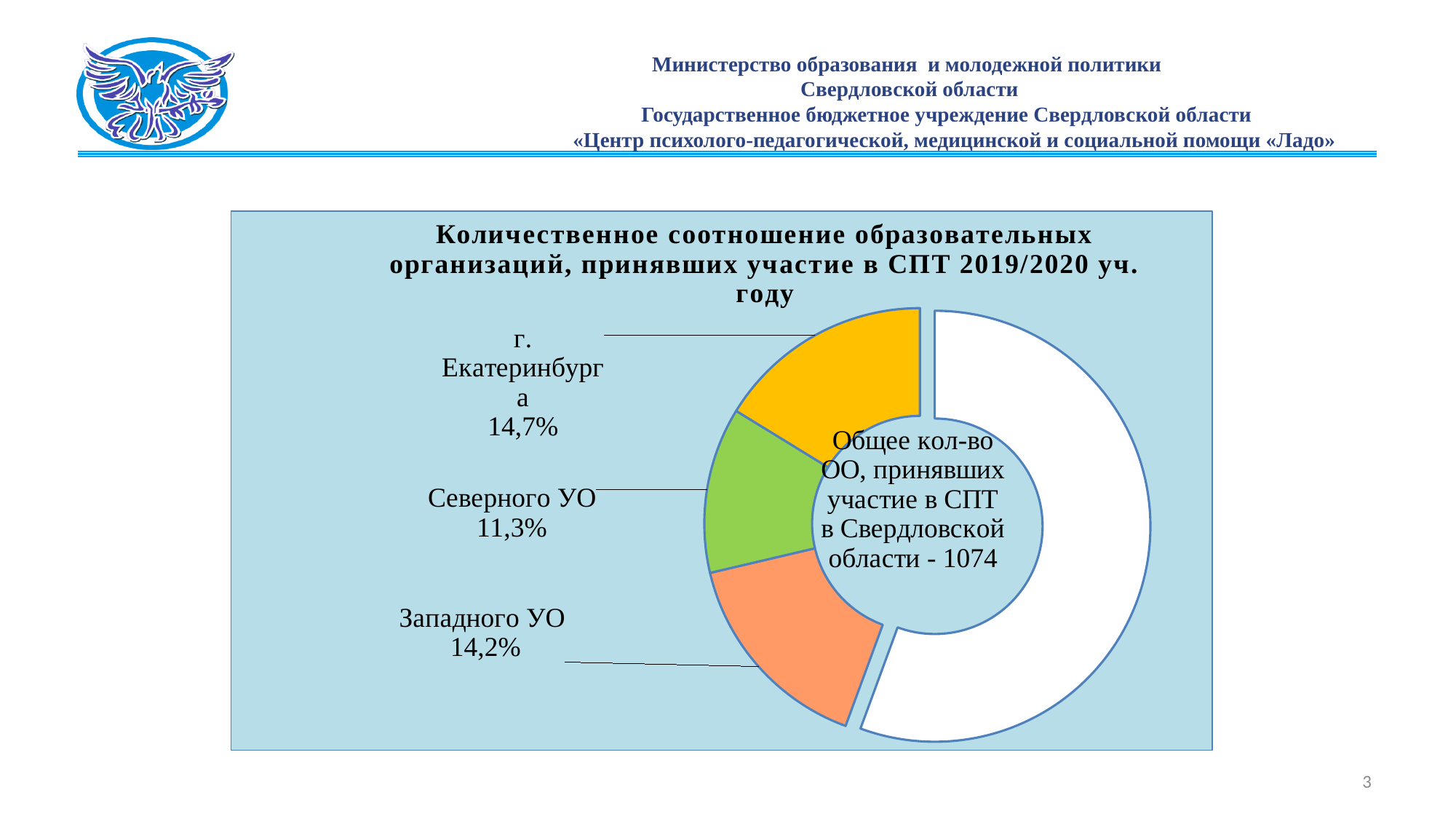
What percentage share is shown for Западного УО? 14,2% What is the difference in percentage points between the shares of Западного УО and Северного УО? 2,9% What percentage share is shown for Северного УО? 11,3% What kind of chart is shown on the slide? Doughnut (pie) chart What is the difference in percentage points between the shares of г. Екатеринбурга and Северного УО? 3,4% How many slices of the chart have a percentage label? 3 Which of the labelled slices has the smallest share? Северного УО Which share is larger: Северного УО or Западного УО? Западного УО What percentage share is shown for г. Екатеринбурга? 14,7% What colour is the slice for Северного УО? Green What total number of educational organisations is stated in the centre of the chart? 1074